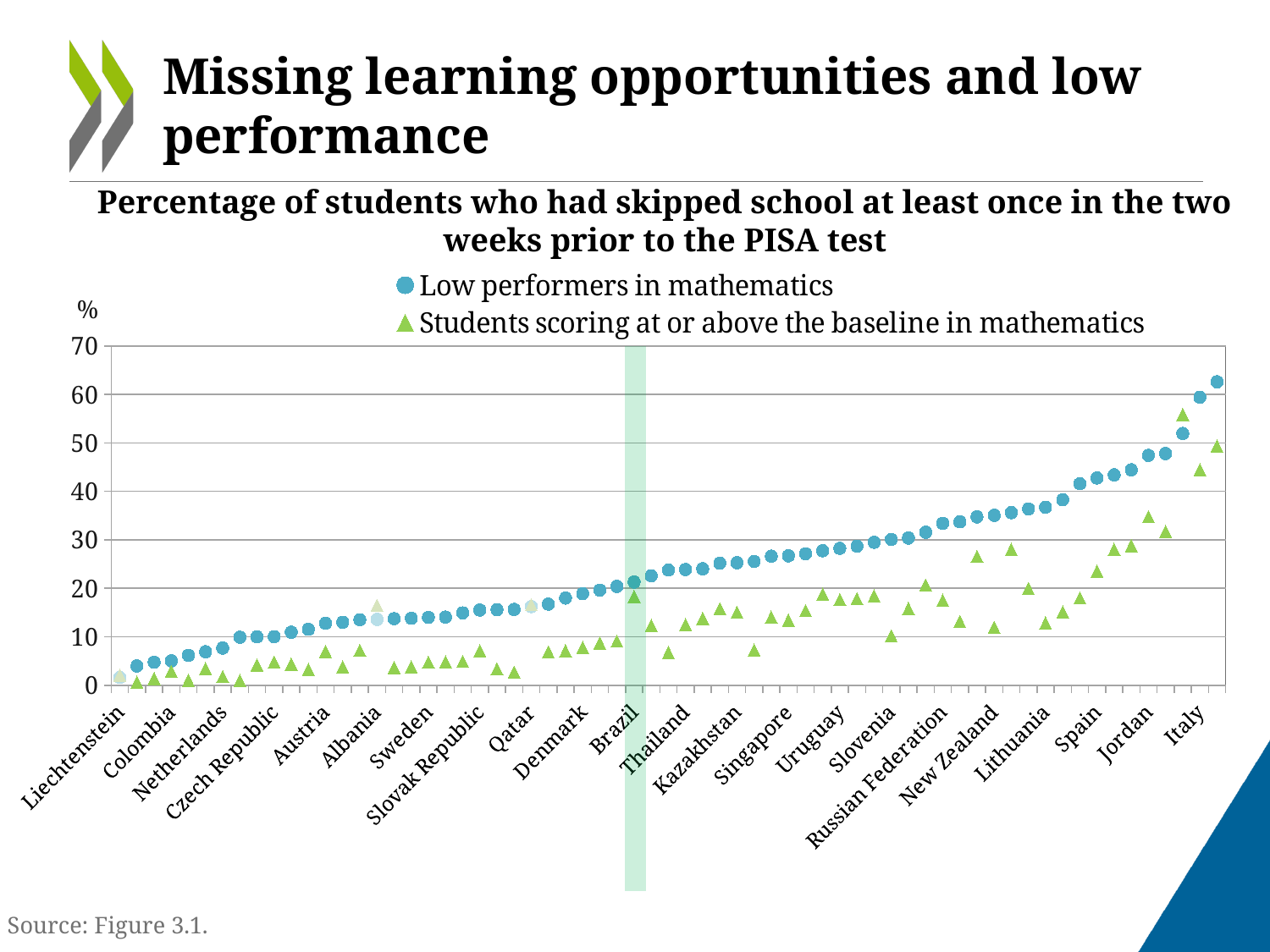
Is the value for low performers in mathematics in Netherlands greater or less than 10? less Which country is highlighted with a shaded vertical band on the chart? Brazil In Italy, which is larger: the value for low performers in mathematics or for students scoring at or above the baseline in mathematics? Low performers in mathematics Is the value for low performers in mathematics in Italy greater or less than 50? greater Which country has the lowest value for low performers in mathematics? Liechtenstein How many series does the legend list? 2 Do the values for low performers in mathematics rise or fall from left to right along the x axis? Rise What kind of chart is shown on the slide? Scatter (dot) chart What is the title of the chart? Percentage of students who had skipped school at least once in the two weeks prior to the PISA test Is the value for low performers in mathematics in Jordan greater or less than 40? greater In Jordan, which is larger: the value for low performers in mathematics or for students scoring at or above the baseline in mathematics? Low performers in mathematics